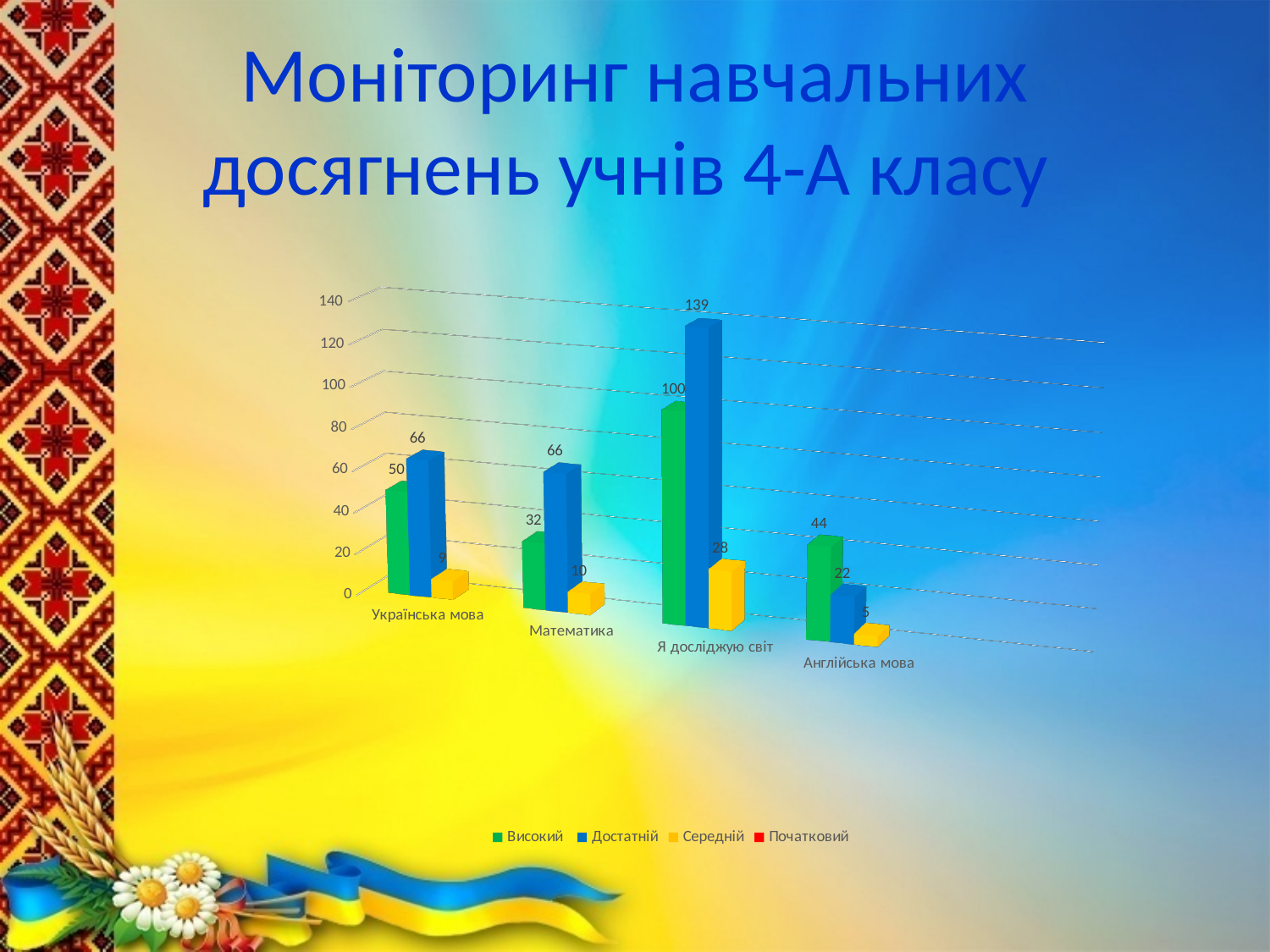
Which category has the lowest Середній value? Англійська мова What colour represents the Середній series in the legend? Yellow What is the value of Високий for Українська мова? 50 What is the value of Достатній for Англійська мова? 22 How many series does the legend list? 4 What is the difference between the Достатній and Високий values for Я досліджую світ? 39 Which category has the highest Високий value? Я досліджую світ What is the value of Середній for Математика? 10 What kind of chart is shown on the slide? Bar chart How many categories are shown on the x axis? 4 What is the value of Достатній for Я досліджую світ? 139 Which is larger for Англійська мова: Високий or Достатній? Високий